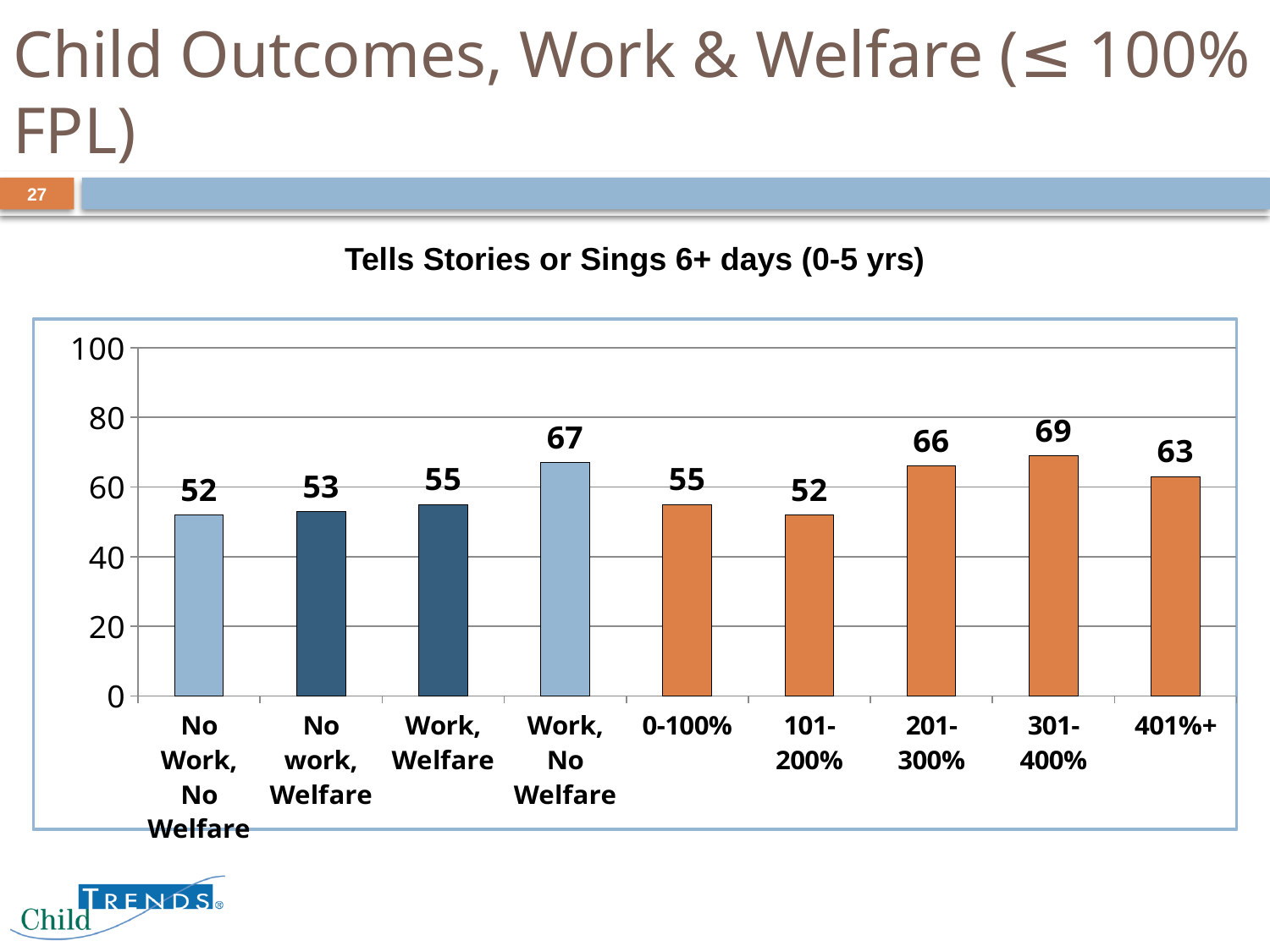
What is the difference between the values for "Work, No Welfare" and "No Work, No Welfare"? 15 Which is larger, the value for "Work, Welfare" or the value for 201-300%? 201-300% How many categories (bars) are shown in the chart? 9 What kind of chart is shown on the slide? bar chart What is the value for the 301-400% category? 69 What is the value for the 101-200% category? 52 What is the title of the chart? Tells Stories or Sings 6+ days (0-5 yrs) What is the value for "No work, Welfare"? 53 What is the difference between the values for 301-400% and 401%+? 6 Which category has the highest value in the chart? 301-400% What is the value for "Work, No Welfare" in the Tells Stories or Sings 6+ days chart? 67 Is the value for 0-100% greater or less than 60? less